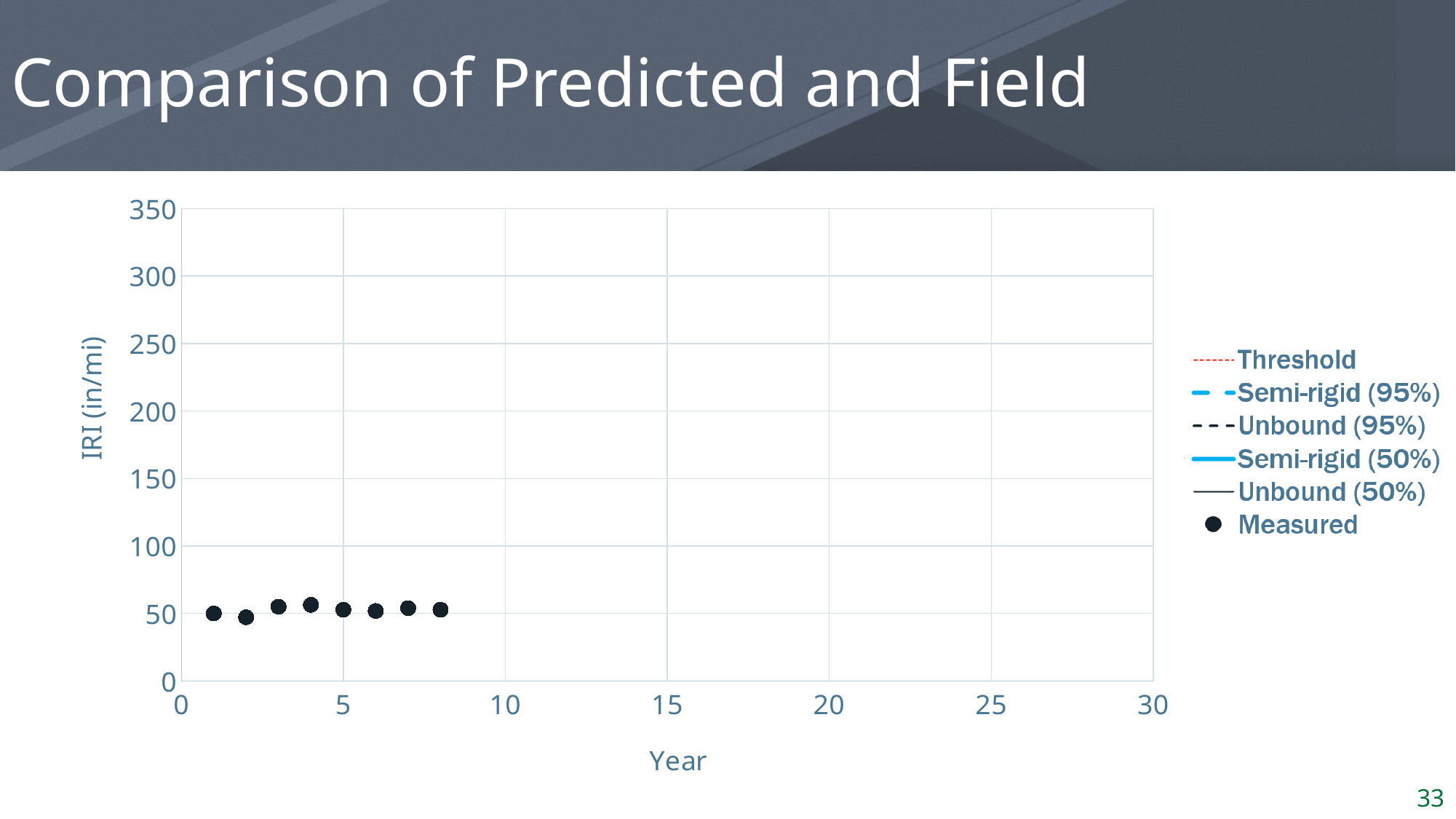
Is the Measured value at year 8 greater or less than 150? less Which is larger, the Measured value at year 4 or at year 2? year 4 Is the Measured value at year 1 greater or less than 100? less What is the maximum value shown on the y axis? 350 What is the maximum value shown on the x axis? 30 What is the label of the y axis? IRI (in/mi) How many series does the legend list? 6 What kind of chart is shown on the slide? scatter chart How many Measured data points are plotted on the chart? 8 Is the Measured value at year 4 greater or less than 50? greater